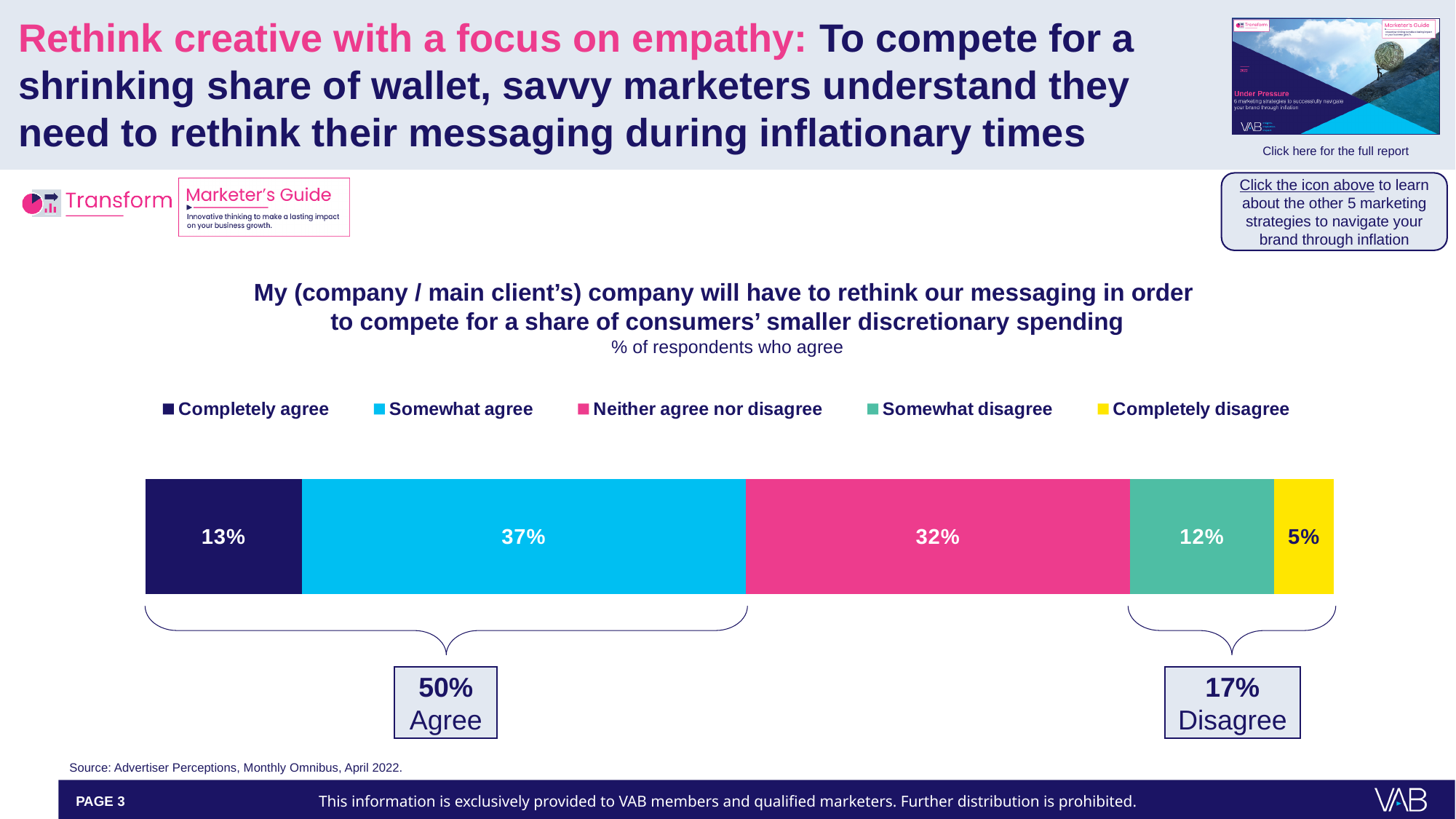
Which response category has the largest share? Somewhat agree What kind of chart is shown on the slide? Stacked bar chart Which response category has the smallest share? Completely disagree What percentage of respondents somewhat agree? 37% What is the combined share of respondents who agree (completely or somewhat), as labelled on the slide? 50% What percentage of respondents neither agree nor disagree? 32% What percentage of respondents somewhat disagree? 12% What is the difference between the Somewhat agree and Neither agree nor disagree shares? 5% What percentage of respondents completely disagree? 5% How many series does the legend list? 5 What percentage of respondents completely agree? 13% Which is larger, the Completely agree share or the Somewhat disagree share? Completely agree